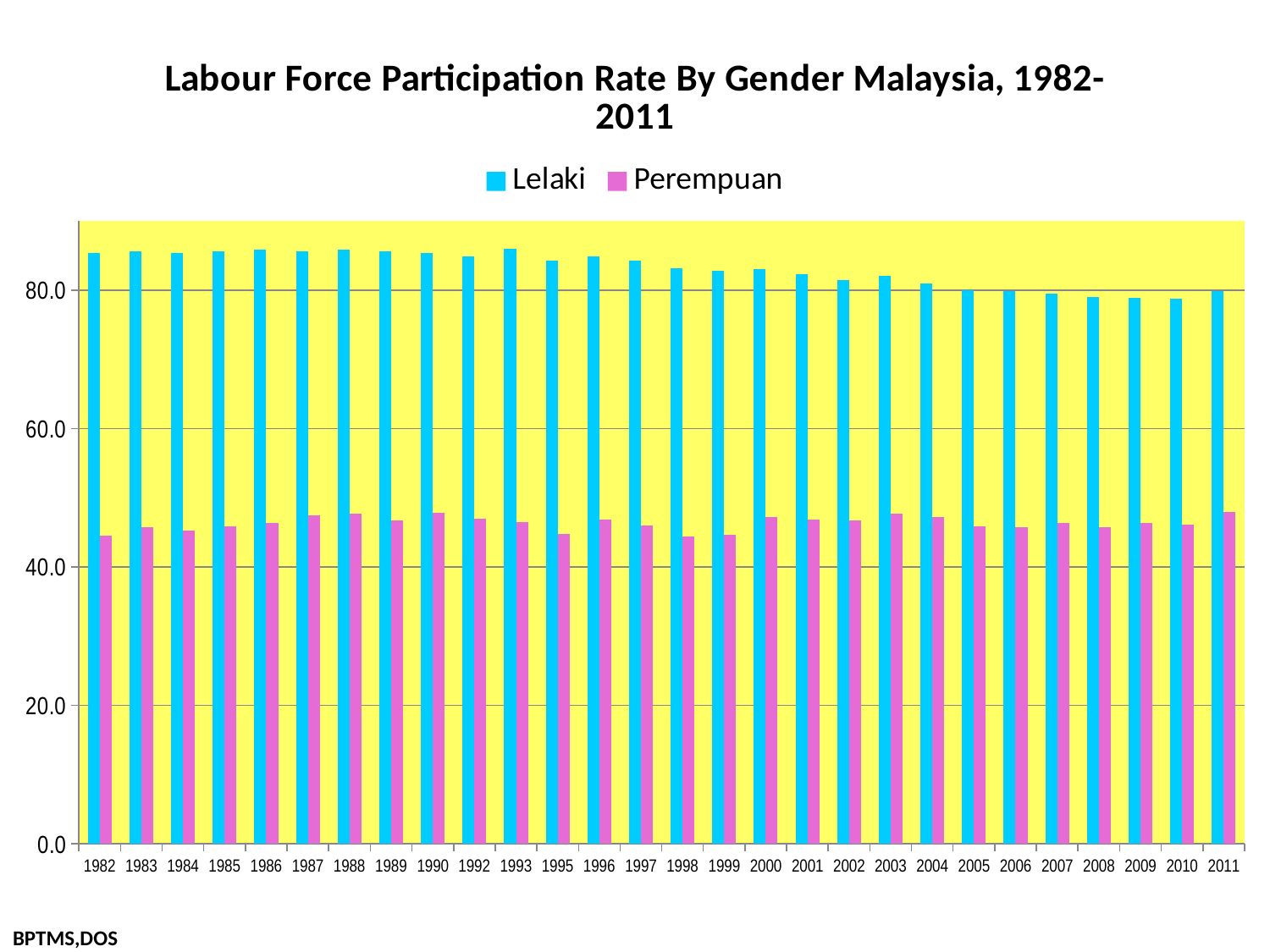
Is the Lelaki value for 1982 greater or less than 80.0? greater Which colour represents the Perempuan series? pink How many years are shown on the x axis? 28 What is the title of the chart? Labour Force Participation Rate By Gender Malaysia, 1982-2011 What kind of chart is shown on the slide? bar chart Which is larger, the Lelaki value for 1982 or the Lelaki value for 2010? 1982 Is the Perempuan value for 1982 greater or less than 40.0? greater Is the Lelaki value for 2010 greater or less than 80.0? less Do the Lelaki values generally rise or fall from 1982 to 2011? fall How many series does the legend list? 2 In 2000, which series has the larger value, Lelaki or Perempuan? Lelaki